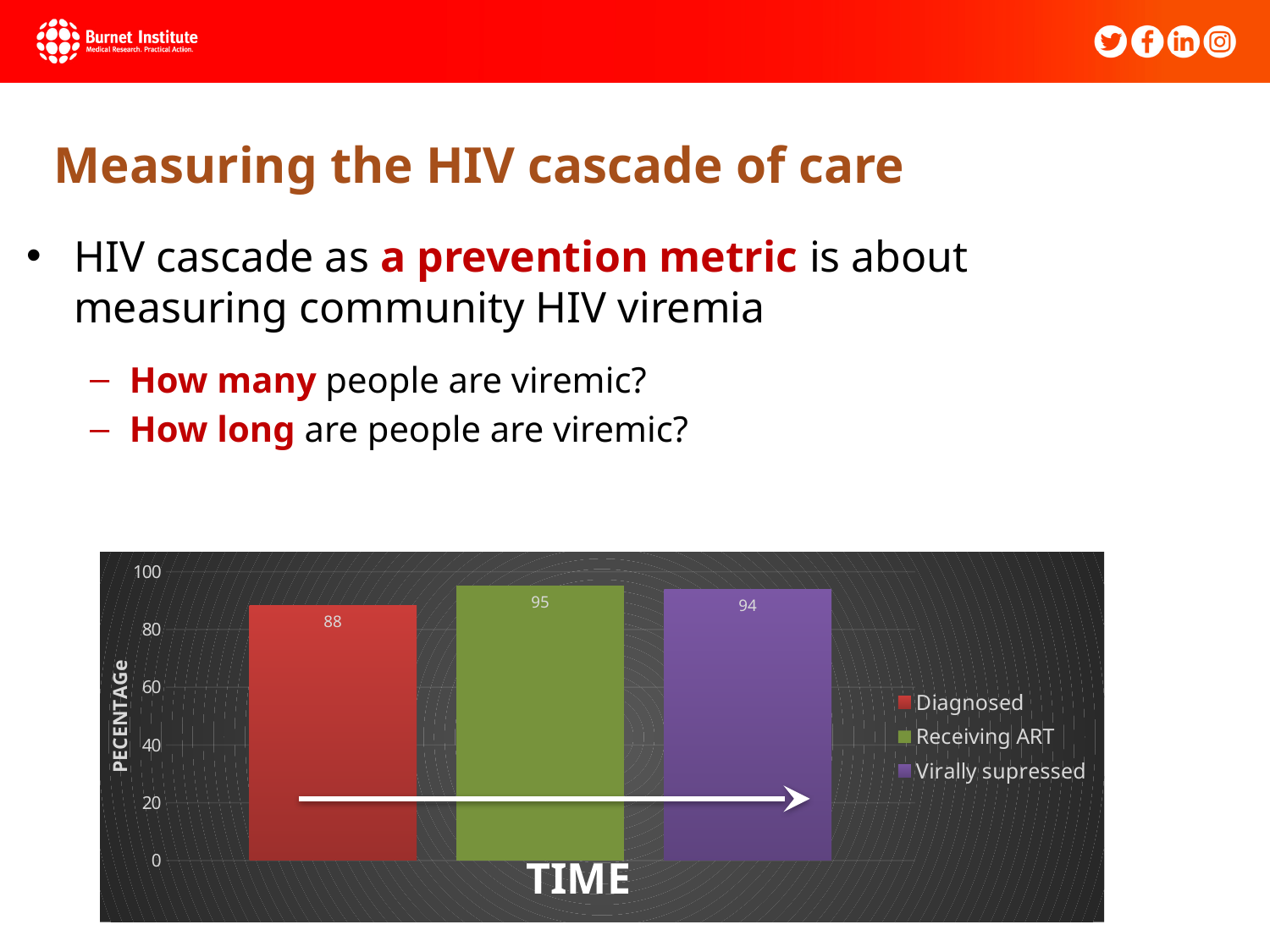
Which is larger, the value for Diagnosed or the value for Virally supressed? Virally supressed What is the label on the vertical axis of the chart? PECENTAGe Which series has the lowest value? Diagnosed Which series has the highest value? Receiving ART What kind of chart is shown on the slide? bar chart How many series does the legend list? 3 What is the value for Receiving ART? 95 What is the value for Virally supressed? 94 How many bars are plotted in the chart? 3 Is the value for Diagnosed greater or less than 80? greater What is the value for Diagnosed? 88 What is the difference between the Receiving ART value and the Diagnosed value? 7